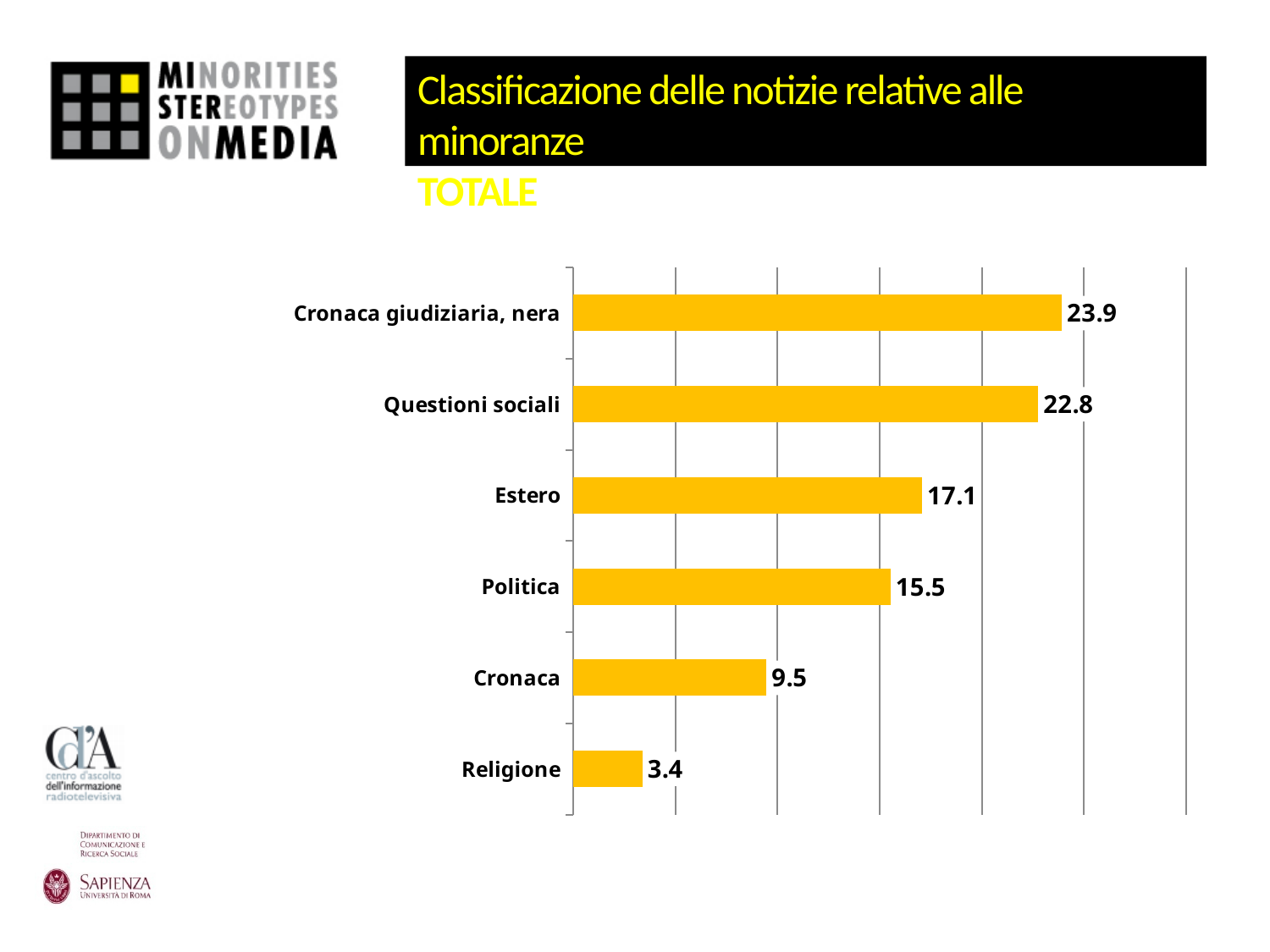
What is the value for Religione? 3.4 What is the value for Questioni sociali? 22.8 Which category has the lowest value? Religione What kind of chart is shown on the slide? Bar chart What is the difference between the values for Politica and Cronaca? 6 What is the value for Estero? 17.1 What is the value for Cronaca giudiziaria, nera? 23.9 What is the difference between the values for Cronaca giudiziaria, nera and Questioni sociali? 1.1 Which is larger, the value for Estero or the value for Politica? Estero Which category has the highest value? Cronaca giudiziaria, nera How many categories are shown in the chart? 6 What colour are the bars in the chart? Yellow